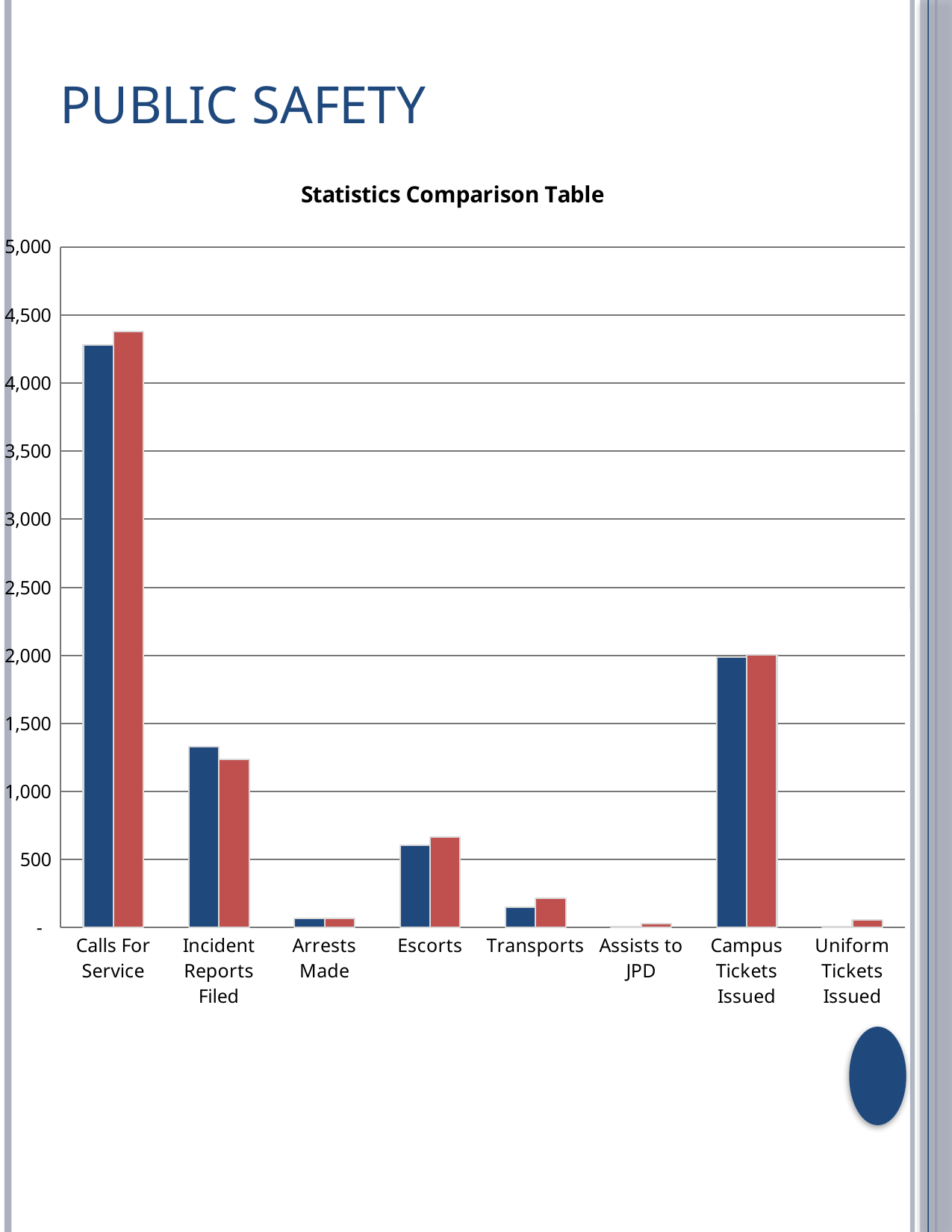
How many categories are shown on the x axis of the chart? 8 Is the red bar for Escorts greater or less than 500? greater Which category has taller bars, Escorts or Campus Tickets Issued? Campus Tickets Issued What is the title of the chart? Statistics Comparison Table Which category has the highest bars in the chart? Calls For Service Is the blue bar for Transports greater or less than 500? less For Calls For Service, which bar is taller, the blue bar or the red bar? the red bar What kind of chart is shown on the slide? bar chart For Incident Reports Filed, which bar is taller, the blue bar or the red bar? the blue bar Is the blue bar for Arrests Made greater or less than 500? less